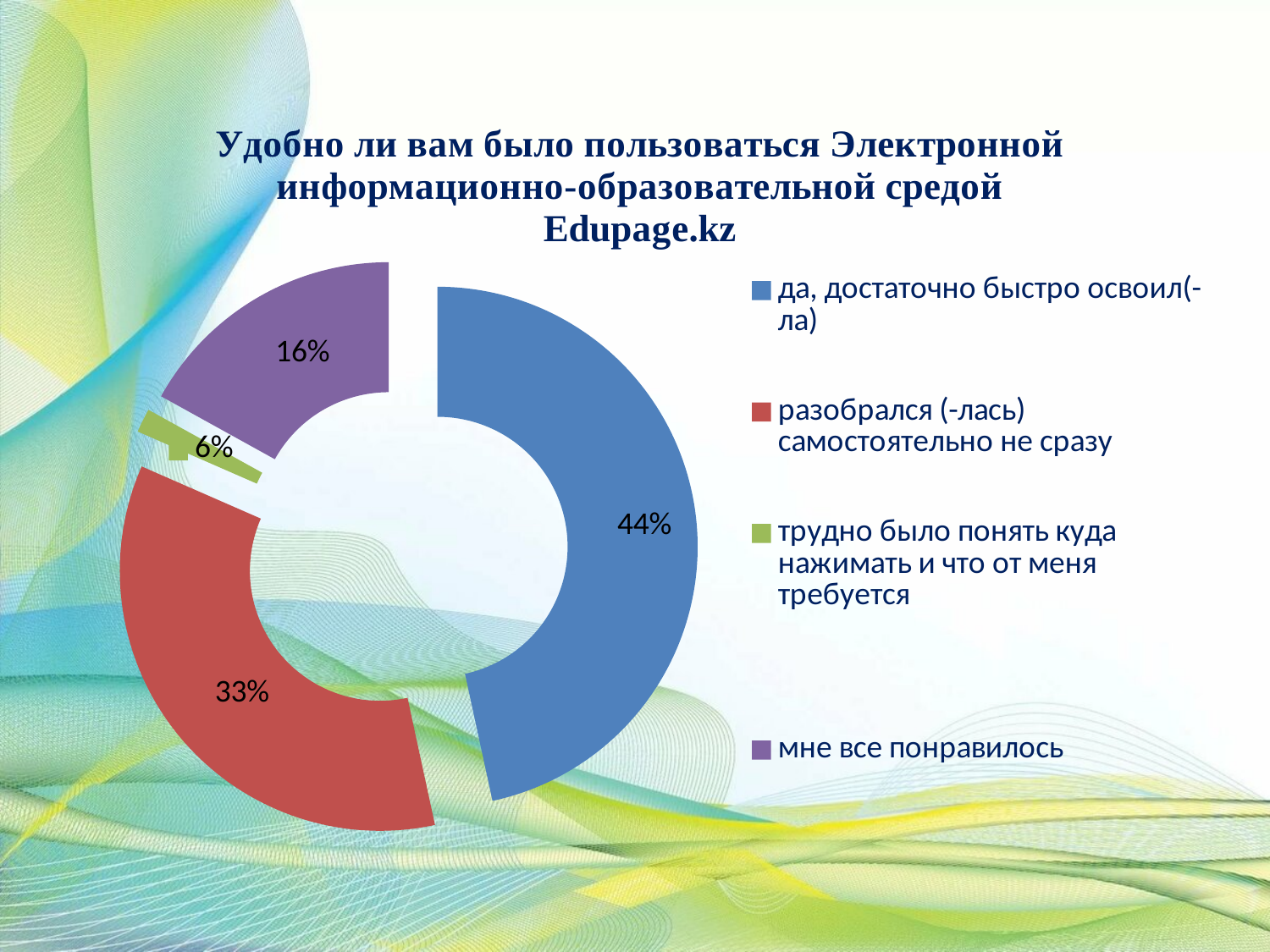
What colour is the slice for "разобрался (-лась) самостоятельно не сразу"? Red What is the title of the chart on the slide? Удобно ли вам было пользоваться Электронной информационно-образовательной средой Edupage.kz Which is larger: the share for "мне все понравилось" or the share for "трудно было понять куда нажимать и что от меня требуется"? мне все понравилось Which answer option has the largest share in the chart? да, достаточно быстро освоил(-ла) What type of chart is shown on the slide? Doughnut (pie) chart What share of respondents answered "разобрался (-лась) самостоятельно не сразу"? 33% What share of respondents answered "мне все понравилось"? 16% What is the difference in percentage points between "да, достаточно быстро освоил(-ла)" and "разобрался (-лась) самостоятельно не сразу"? 11 percentage points What share of respondents answered "да, достаточно быстро освоил(-ла)"? 44% Which answer option has the smallest share in the chart? трудно было понять куда нажимать и что от меня требуется How many answer options (slices) does the chart show? 4 What share of respondents answered "трудно было понять куда нажимать и что от меня требуется"? 6%